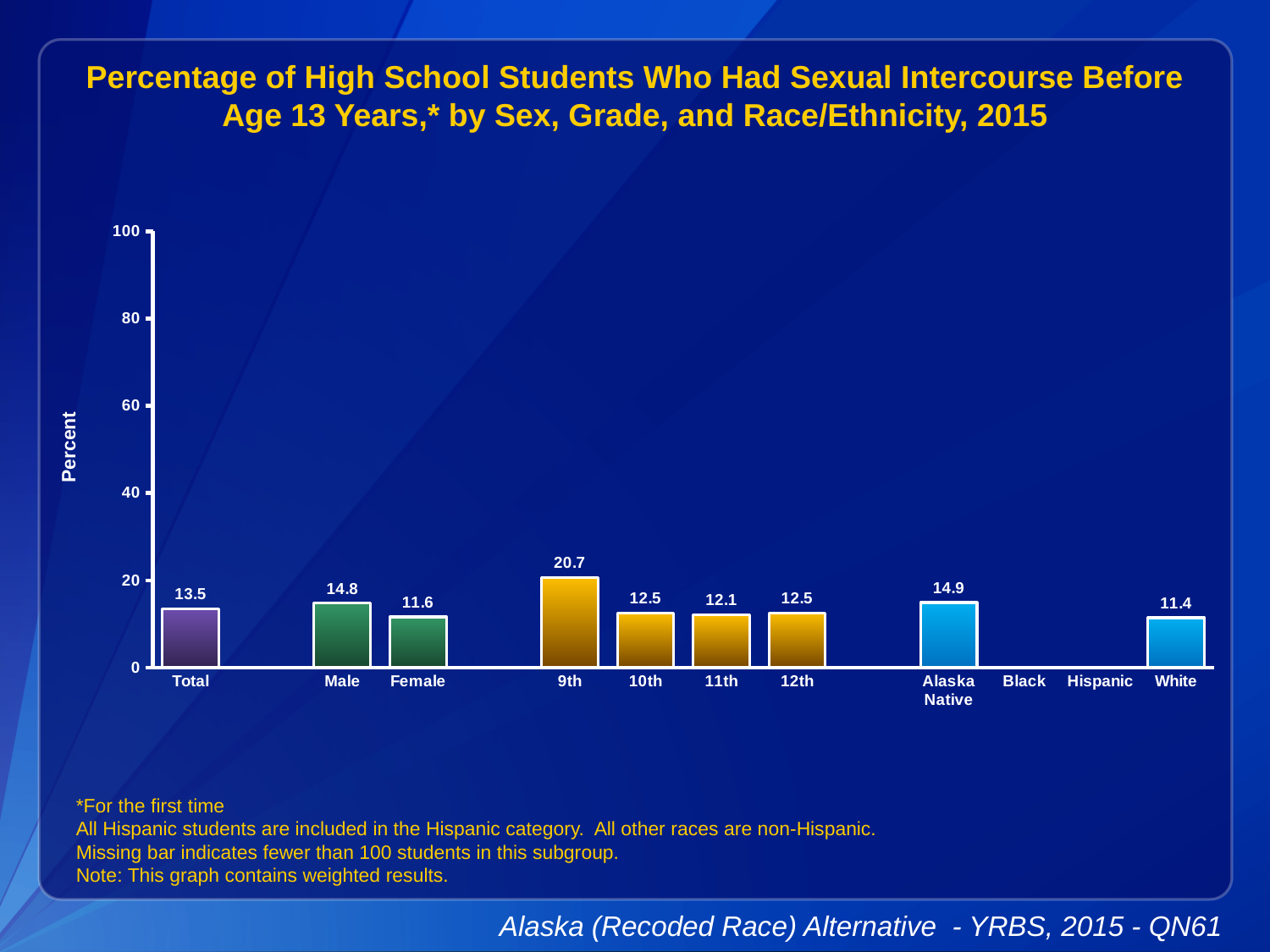
Is the value for 9th grade greater or less than 20? greater Which category has the highest value? 9th What is the label on the y axis? Percent How many categories are labeled on the x axis? 11 What is the difference between the values for Male and Female? 3.2 What is the value for Total? 13.5 What is the value for Alaska Native students? 14.9 Which category with a plotted bar has the lowest value? White Do the values fall or rise from 9th grade to 10th grade? fall What is the value for 9th grade students? 20.7 What kind of chart is shown? bar chart Which is larger, the value for 9th grade or the value for 12th grade? 9th